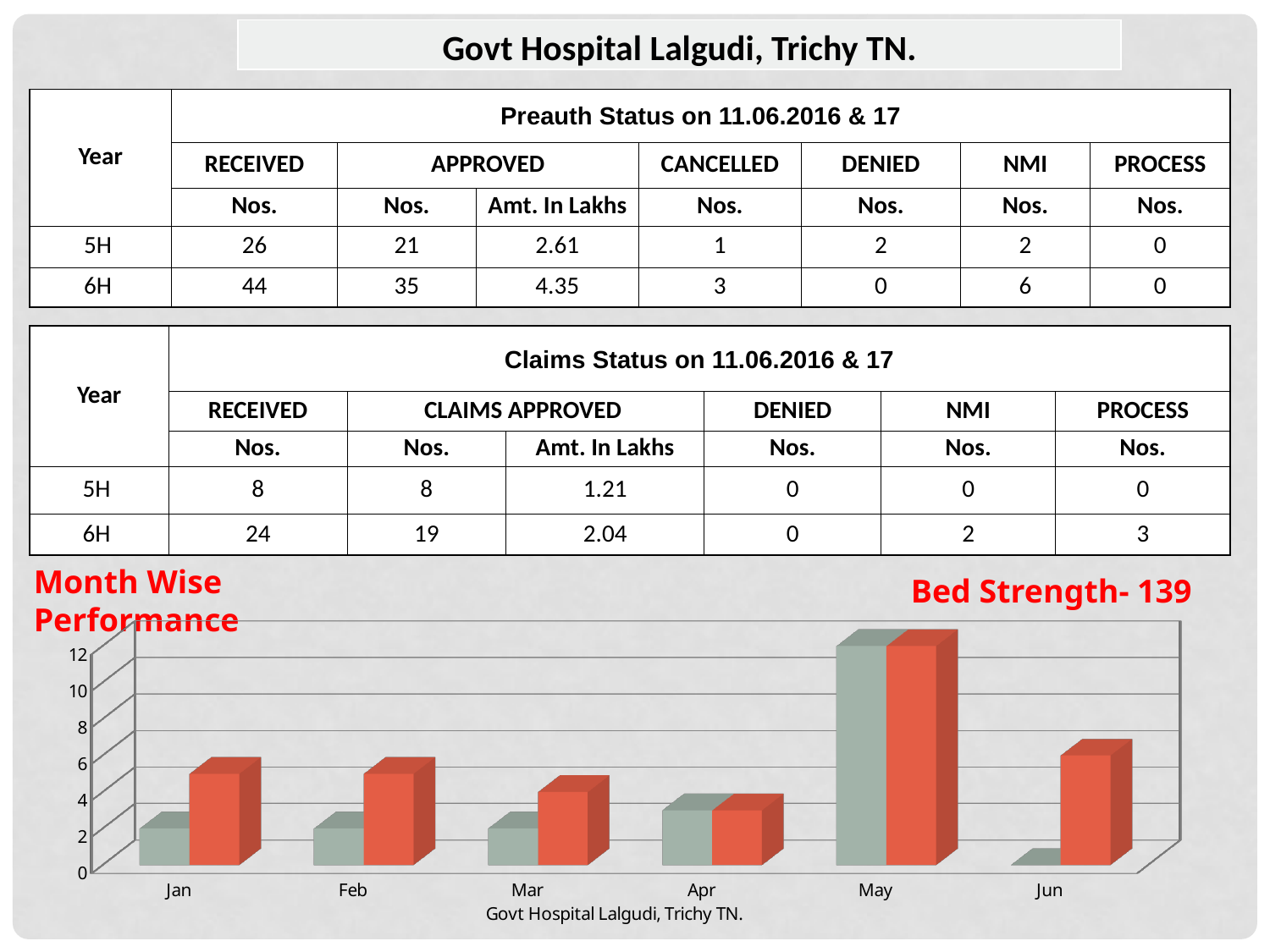
How many months are shown on the x axis of the Month Wise Performance chart? 6 In the Month Wise Performance chart, is the grey bar for Feb greater or less than 4? less What is the highest value shown on the vertical axis of the Month Wise Performance chart? 12 In the Month Wise Performance chart, which month has the lowest grey bar? Jun In the Month Wise Performance chart, which month has the tallest bars? May What kind of chart is shown at the bottom of the slide? bar chart In the Month Wise Performance chart, which is larger: the grey bar for May or the grey bar for Jan? the grey bar for May In the Month Wise Performance chart, is the red bar for Jan greater or less than 4? greater In the Month Wise Performance chart, is the grey bar for Jun greater or less than 2? less What text appears below the x axis of the Month Wise Performance chart? Govt Hospital Lalgudi, Trichy TN. In the Month Wise Performance chart, which is larger for Jun: the grey bar or the red bar? the red bar